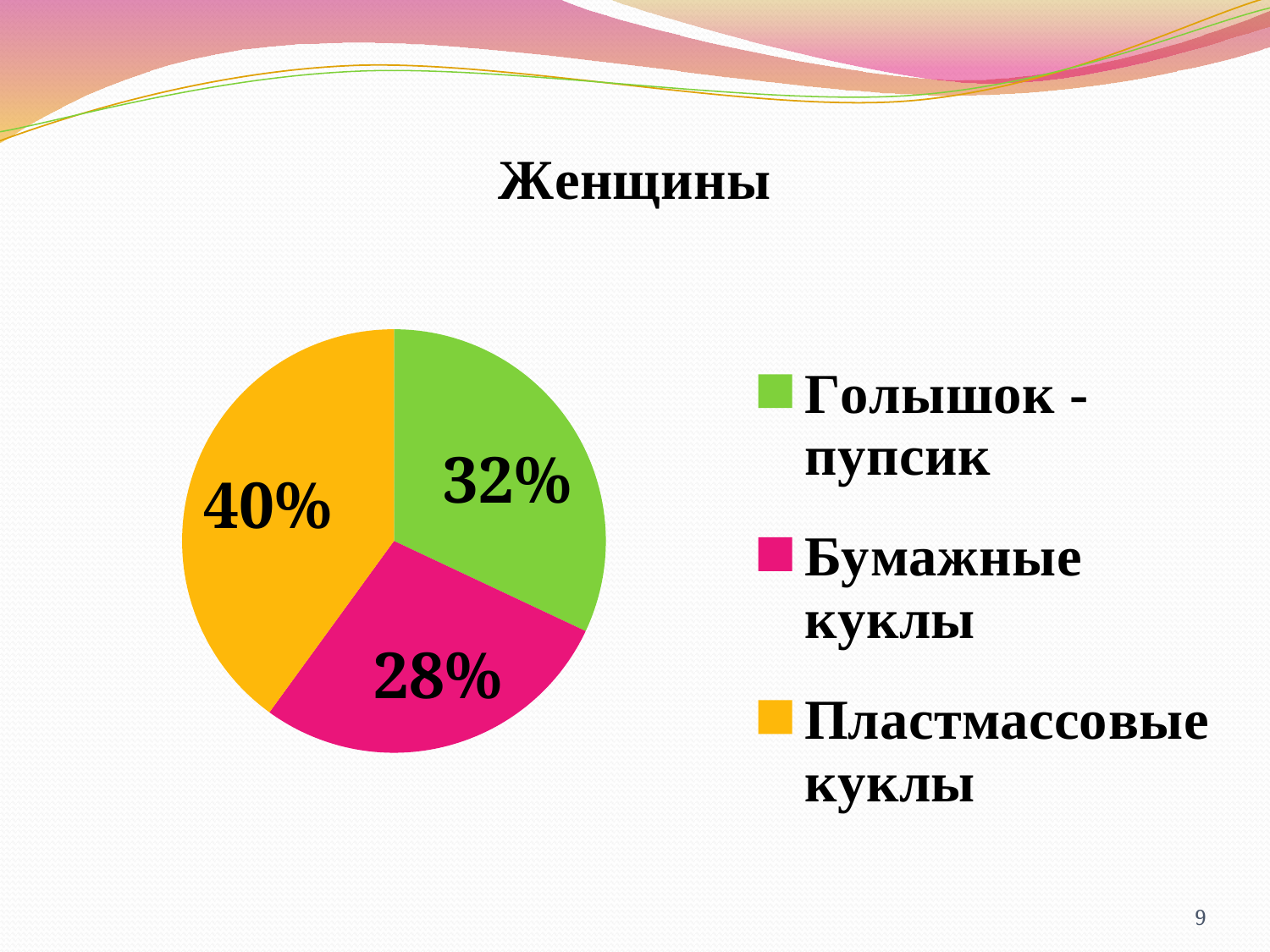
What is the title of the chart? Женщины Which is larger, the share for Голышок - пупсик or the share for Бумажные куклы? Голышок - пупсик What percentage is shown for Бумажные куклы? 28% What colour is the slice for Бумажные куклы? pink What is the difference in percentage points between Пластмассовые куклы and Бумажные куклы? 12 Which category has the largest share of the pie? Пластмассовые куклы What percentage is shown for Голышок - пупсик? 32% What type of chart is shown on the slide? pie chart How many entries does the legend list? 3 What percentage is shown for Пластмассовые куклы? 40% How many slices does the pie chart have? 3 Which category has the smallest share of the pie? Бумажные куклы